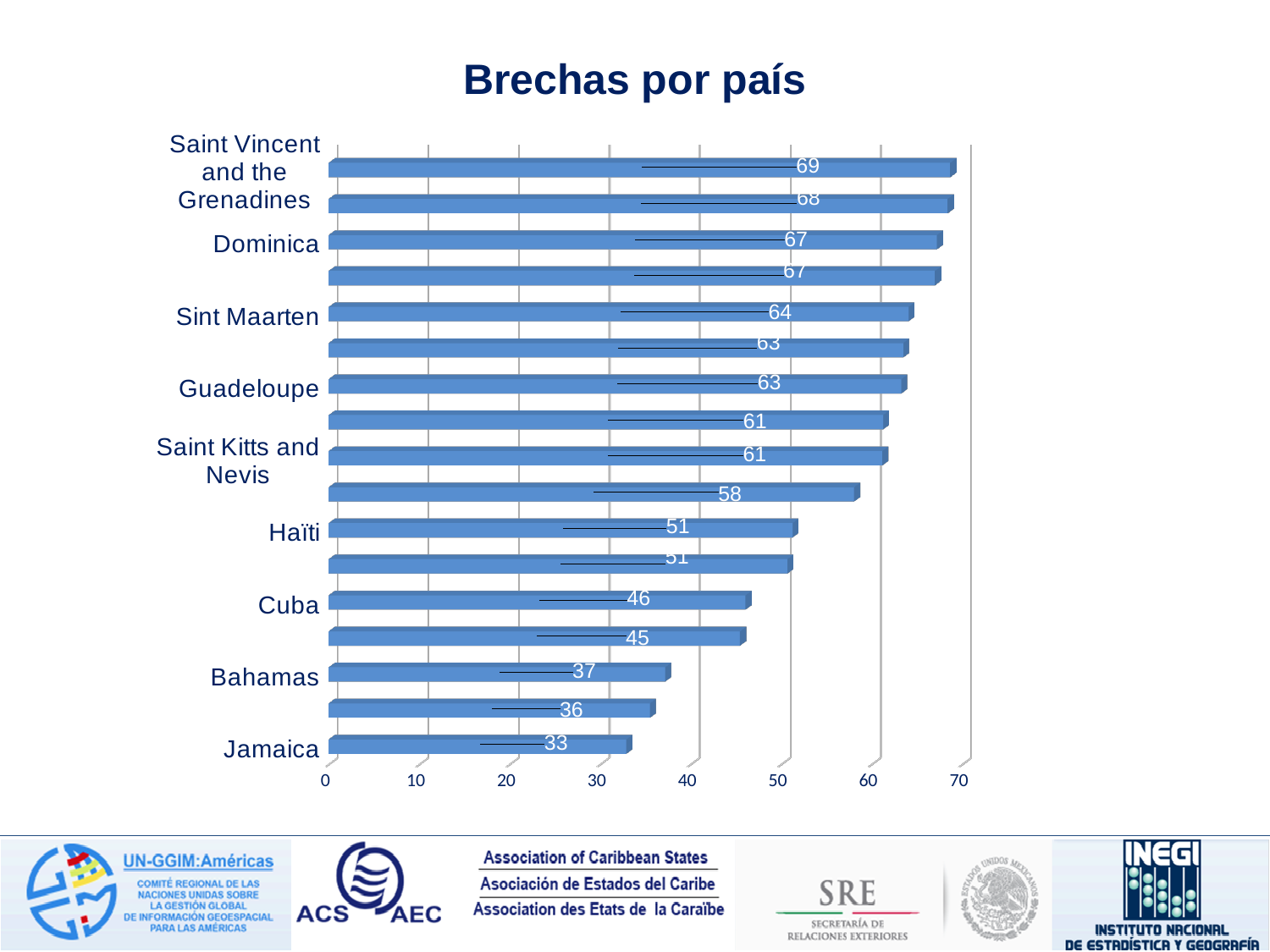
What type of chart is shown on the slide? bar chart What is the difference between the values for Guadeloupe and Bahamas? 26 Which labelled country has the lowest value? Jamaica What is the value for Sint Maarten? 64 Which labelled country has the highest value? Saint Vincent and the Grenadines What is the title of the chart? Brechas por país Which has a larger value, Haïti or Saint Kitts and Nevis? Saint Kitts and Nevis What is the value for Saint Vincent and the Grenadines? 69 What is the value for Cuba? 46 What is the value for Dominica? 67 Is the value for Bahamas greater or less than 40? less What is the value for Jamaica? 33